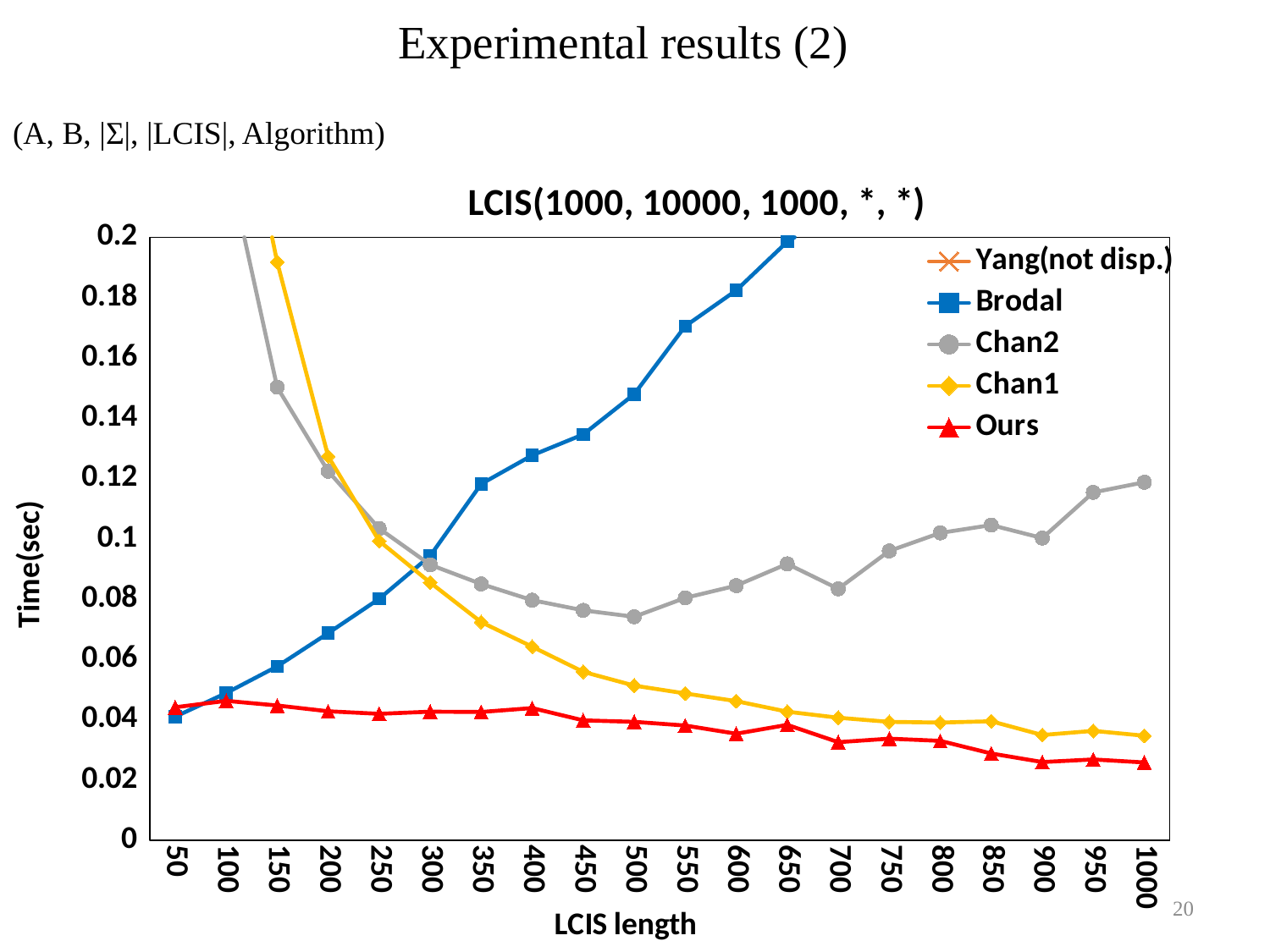
How many series does the legend list? 5 Is the value for Chan1 at LCIS length 1000 greater or less than 0.04? less Is the value for Brodal at LCIS length 500 greater or less than 0.14? greater Is the value for Chan2 at LCIS length 500 greater or less than 0.08? less What kind of chart is shown on the slide? line chart How many LCIS length values are marked along the x axis? 20 At LCIS length 1000, which series has the lowest time? Ours What is the label of the y axis? Time(sec) Does the Brodal series rise or fall as LCIS length increases? rise Does the Chan1 series rise or fall as LCIS length increases? fall What is the title of the chart? LCIS(1000, 10000, 1000, *, *)